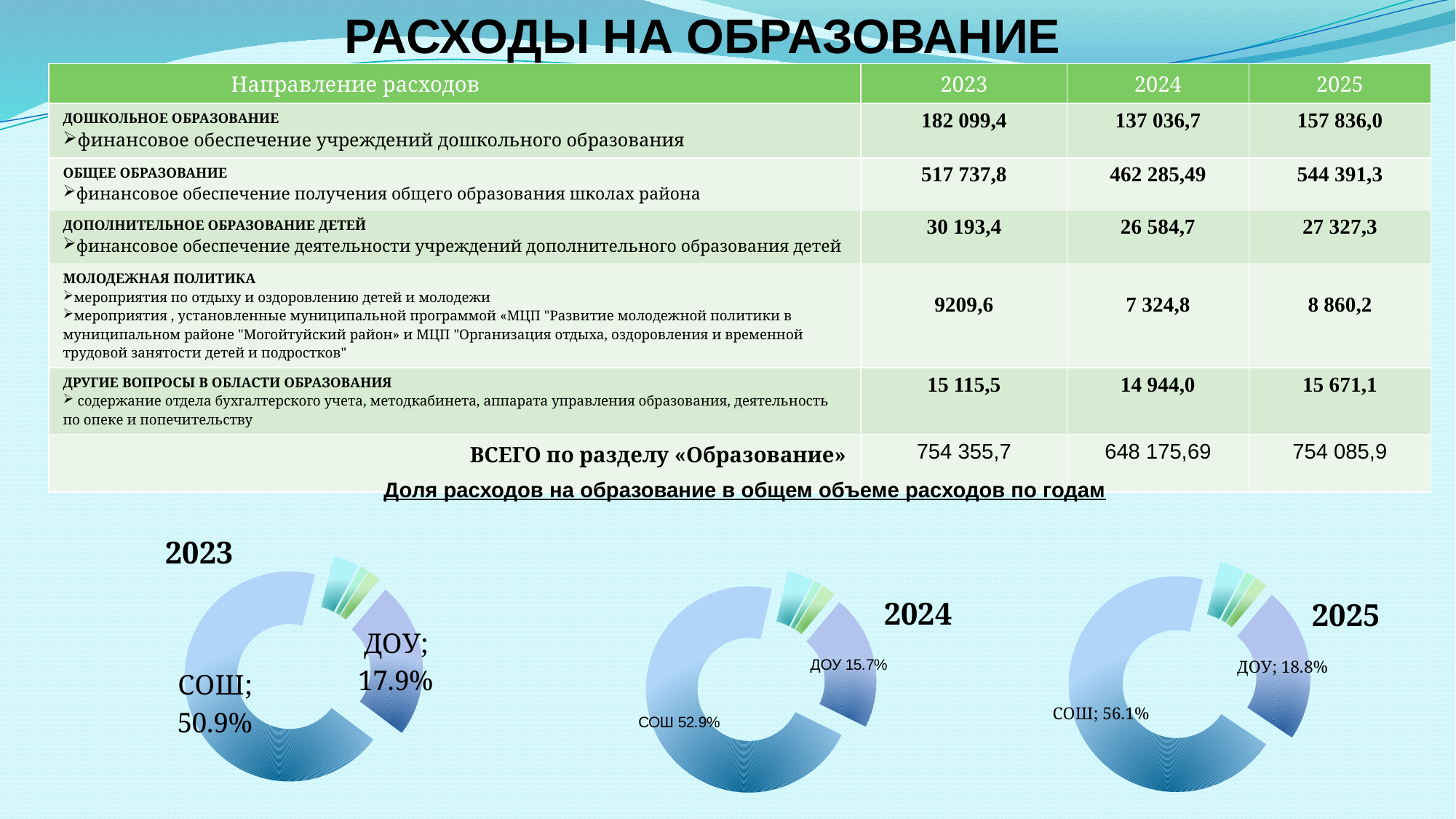
In the 2025 doughnut chart, what share is labelled for СОШ? 56.1% In the 2023 doughnut chart, which is larger, the СОШ slice or the ДОУ slice? СОШ In the 2024 doughnut chart, what share is labelled for СОШ? 52.9% How many doughnut charts are shown on the slide? 3 In the 2023 doughnut chart, what share is labelled for ДОУ? 17.9% Across the three doughnut charts from 2023 to 2025, does the СОШ share rise or fall? rise What kind of chart is used to show the share of education expenses for each year? doughnut (pie) chart In the 2025 doughnut chart, what share is labelled for ДОУ? 18.8% In the 2023 doughnut chart, what share is labelled for СОШ? 50.9% In the 2025 doughnut chart, which labelled slice is the largest? СОШ In the 2024 doughnut chart, by how many percentage points does the СОШ share exceed the ДОУ share? 37.2 In the 2024 doughnut chart, what share is labelled for ДОУ? 15.7%